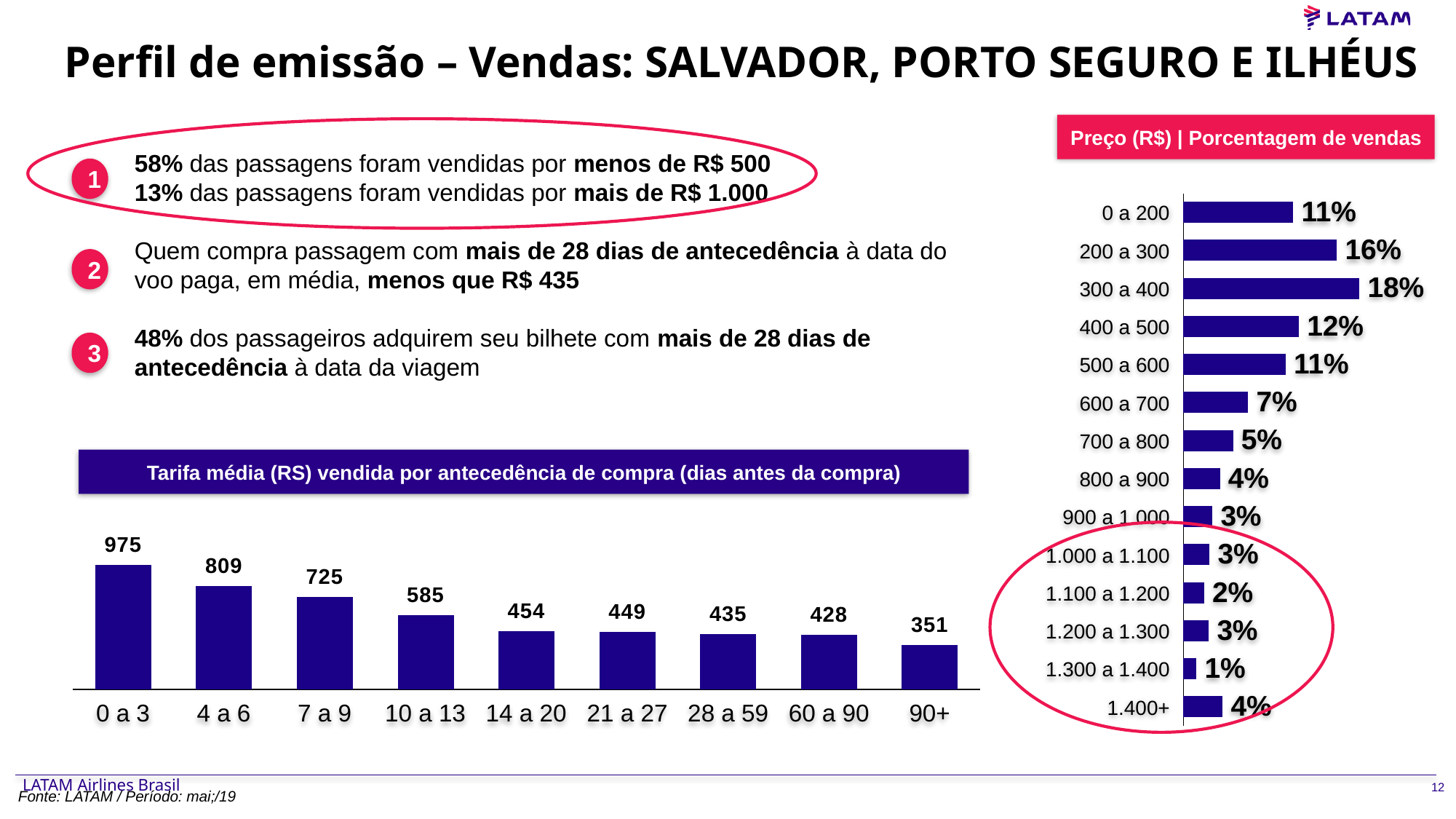
In the 'Tarifa média' chart, what is the value for '0 a 3'? 975 In the 'Tarifa média' chart, what is the value for '28 a 59'? 435 In the 'Preço (R$) | Porcentagem de vendas' chart, which price range has the lowest percentage? 1.300 a 1.400 In the 'Tarifa média' chart, how many categories are shown on the x axis? 9 In the 'Preço (R$) | Porcentagem de vendas' chart, which is larger: the value for '200 a 300' or the value for '400 a 500'? 200 a 300 In the 'Preço (R$) | Porcentagem de vendas' chart, how many price ranges are listed? 14 In the 'Preço (R$) | Porcentagem de vendas' chart, what is the value for '300 a 400'? 18% In the 'Preço (R$) | Porcentagem de vendas' chart, what is the difference between the values for '300 a 400' and '600 a 700'? 11% In the 'Tarifa média' chart, what is the difference between the values for '0 a 3' and '4 a 6'? 166 What kind of chart is the 'Preço (R$) | Porcentagem de vendas' chart? bar chart In the 'Tarifa média' chart, do the values rise or fall from left to right along the x axis? fall In the 'Tarifa média' chart, which category has the lowest value? 90+